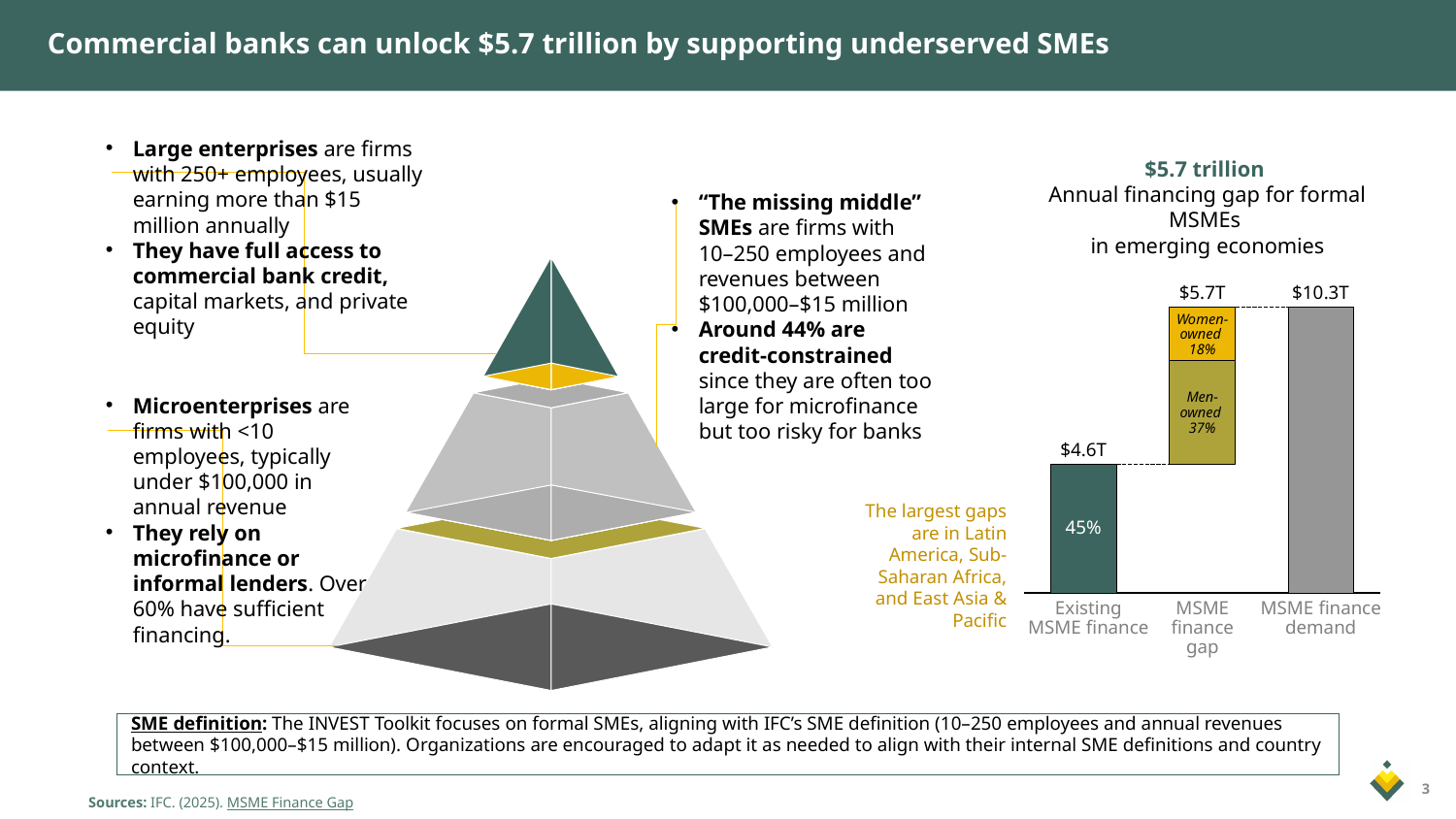
What percentage of the MSME finance gap is labelled as men-owned? 37% What percentage label appears inside the Existing MSME finance bar? 45% Which is larger, Existing MSME finance or the MSME finance gap? MSME finance gap Which category has the highest value in the bar chart? MSME finance demand What percentage of the MSME finance gap is labelled as women-owned? 18% How many categories are shown on the x axis of the bar chart? 3 What is the difference between MSME finance demand and Existing MSME finance? $5.7T What is the value shown for the MSME finance gap bar? $5.7T What type of chart is used to show the MSME financing gap? Bar chart Which category has the lowest value in the bar chart? Existing MSME finance What is the value of the MSME finance demand bar? $10.3T What is the value of the Existing MSME finance bar? $4.6T